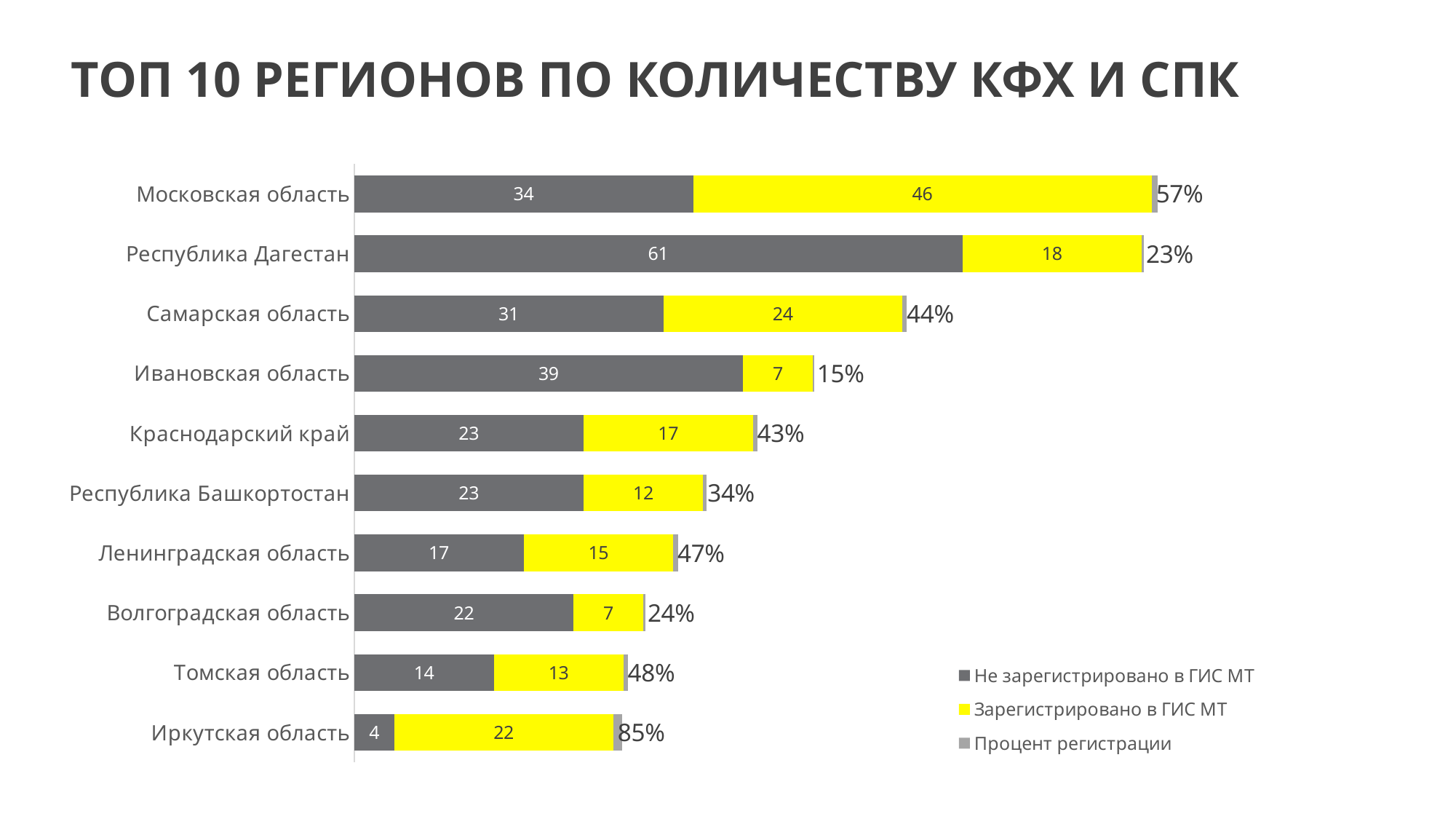
What is the difference between the 'Зарегистрировано в ГИС МТ' values for Московская область and Самарская область? 22 How many series does the legend list? 3 What is the 'Процент регистрации' for Иркутская область? 85% What kind of chart is shown on the slide? Stacked bar chart Which region has the highest 'Не зарегистрировано в ГИС МТ' value? Республика Дагестан How many regions are shown on the chart? 10 What is the value of 'Не зарегистрировано в ГИС МТ' for Республика Дагестан? 61 Which is larger: the 'Зарегистрировано в ГИС МТ' value for Краснодарский край or for Республика Башкортостан? Краснодарский край What is the total of the 'Не зарегистрировано в ГИС МТ' and 'Зарегистрировано в ГИС МТ' segments for Томская область? 27 Which region has the lowest 'Процент регистрации'? Ивановская область What colour represents the 'Зарегистрировано в ГИС МТ' series? Yellow What is the value of 'Зарегистрировано в ГИС МТ' for Московская область? 46